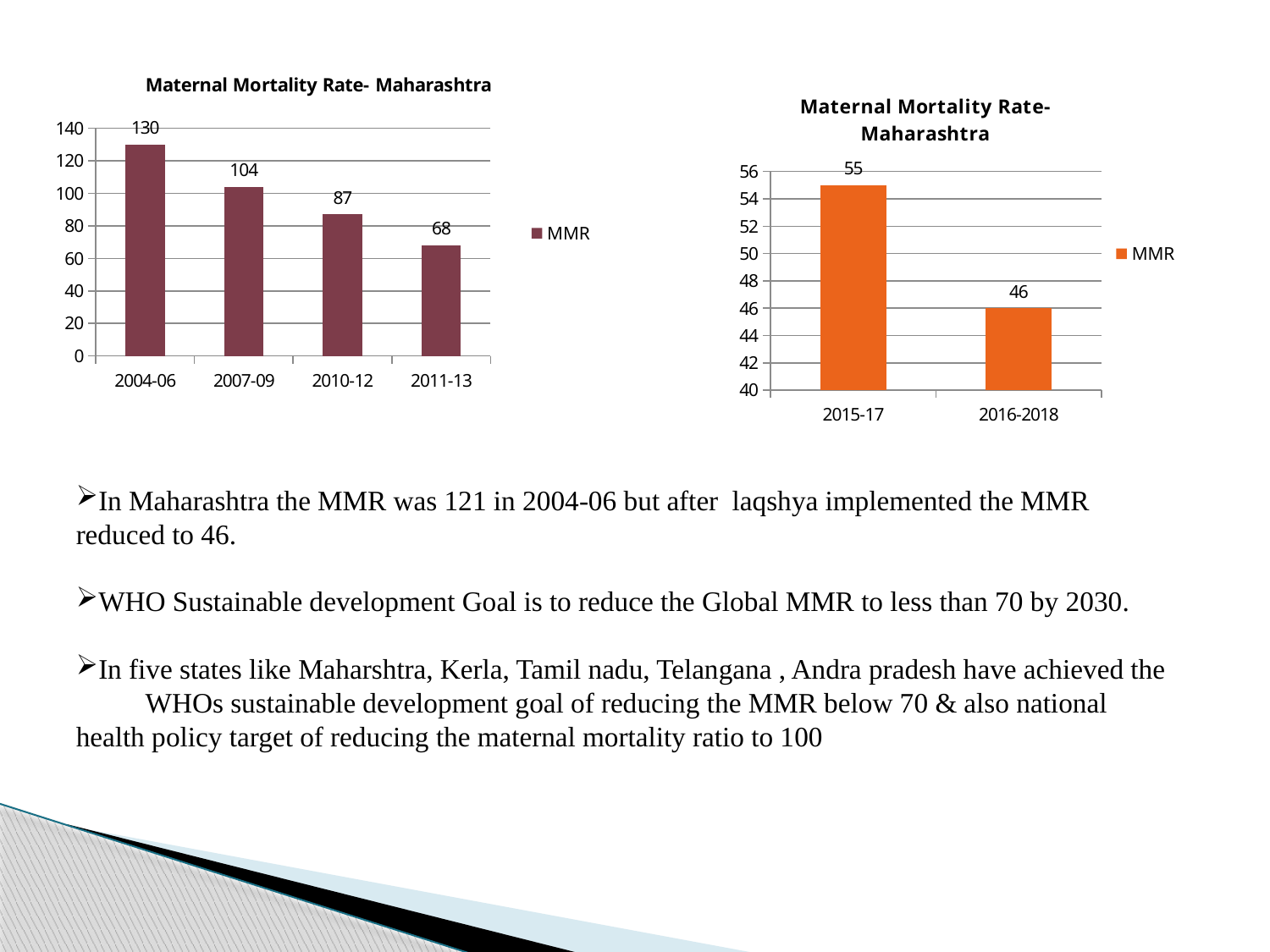
In the left chart, what is the difference between the MMR for 2007-09 and 2010-12? 17 In the left chart, which period has the lowest MMR? 2011-13 In the left chart, which period has the highest MMR? 2004-06 In the right chart, what is the difference between the MMR for 2015-17 and 2016-2018? 9 In the left chart, how many periods are shown on the x axis? 4 What kind of chart is the right chart? bar chart In the left chart, which is larger, the MMR for 2007-09 or for 2011-13? 2007-09 In the right chart, how many periods are shown on the x axis? 2 In the left chart, what is the MMR value for 2011-13? 68 In the left chart, do the MMR values rise or fall from 2004-06 to 2011-13? fall In the right chart, what is the MMR value for 2016-2018? 46 In the left chart, what is the MMR value for 2004-06? 130